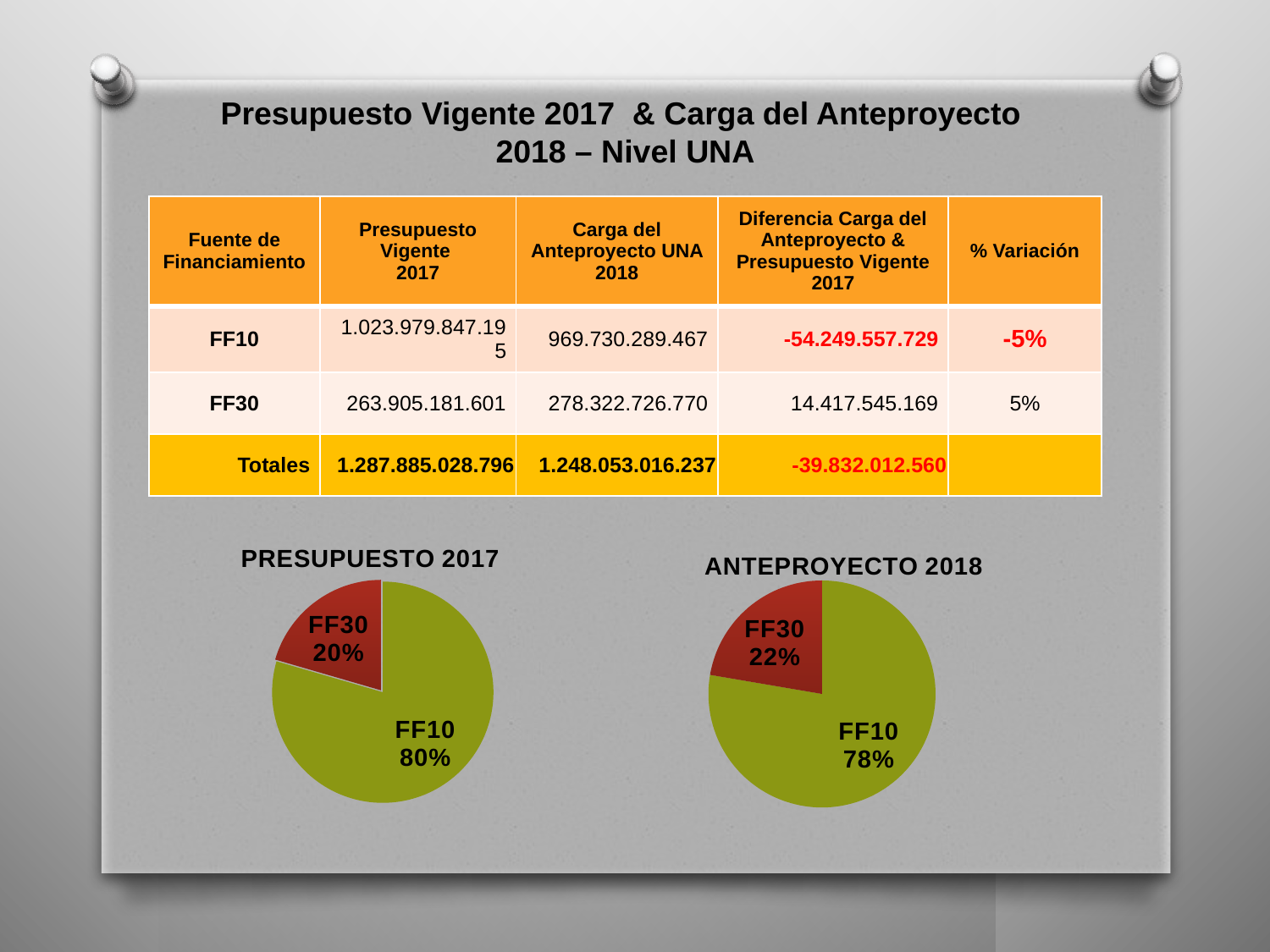
What is the title of the pie chart on the right? ANTEPROYECTO 2018 In the ANTEPROYECTO 2018 chart, which slice is larger, FF10 or FF30? FF10 What kind of chart is the PRESUPUESTO 2017 chart? Pie chart In the PRESUPUESTO 2017 chart, what is the difference in percentage points between the FF10 and FF30 shares? 60 percentage points In the ANTEPROYECTO 2018 chart, what share does FF10 have? 78% How many slices does the ANTEPROYECTO 2018 chart have? 2 In the PRESUPUESTO 2017 chart, what share does FF30 have? 20% In the PRESUPUESTO 2017 chart, what share does FF10 have? 80% In the PRESUPUESTO 2017 chart, what colour is the FF30 slice? Red In the ANTEPROYECTO 2018 chart, which slice is the smallest? FF30 In the PRESUPUESTO 2017 chart, which slice is the largest? FF10